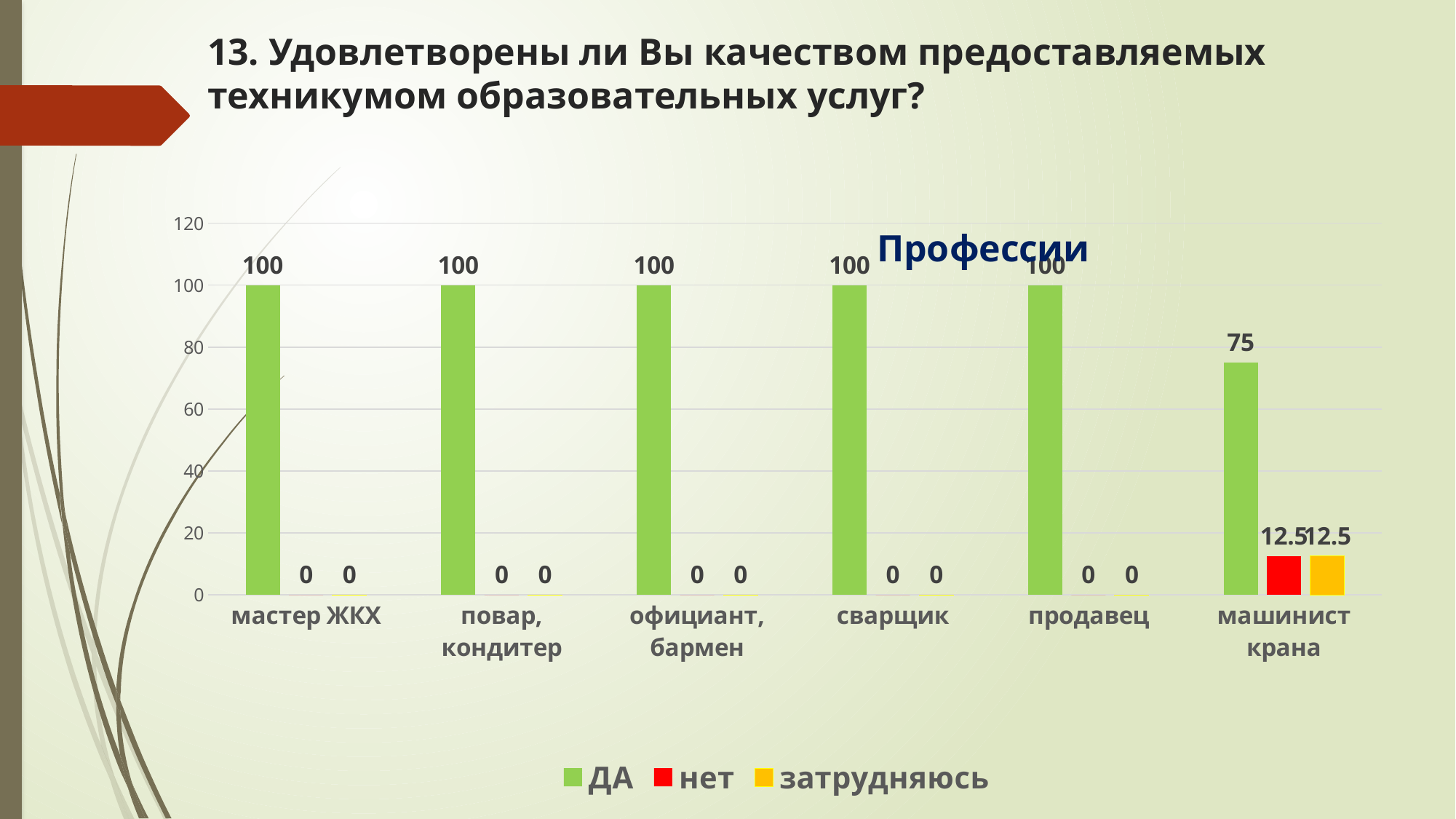
What kind of chart is shown on the slide? bar chart How many series does the legend list? 3 What is the value of ДА for сварщик? 100 Which category has the lowest value for ДА? машинист крана What is the difference between the ДА value for мастер ЖКХ and the ДА value for машинист крана? 25 Which is larger for машинист крана: ДА or нет? ДА What is the value of затрудняюсь for продавец? 0 What is the value of нет for машинист крана? 12.5 What colour represents the series нет in the legend? red How many categories are shown on the x axis? 6 What is the title of the chart? Профессии What is the value of ДА for машинист крана? 75